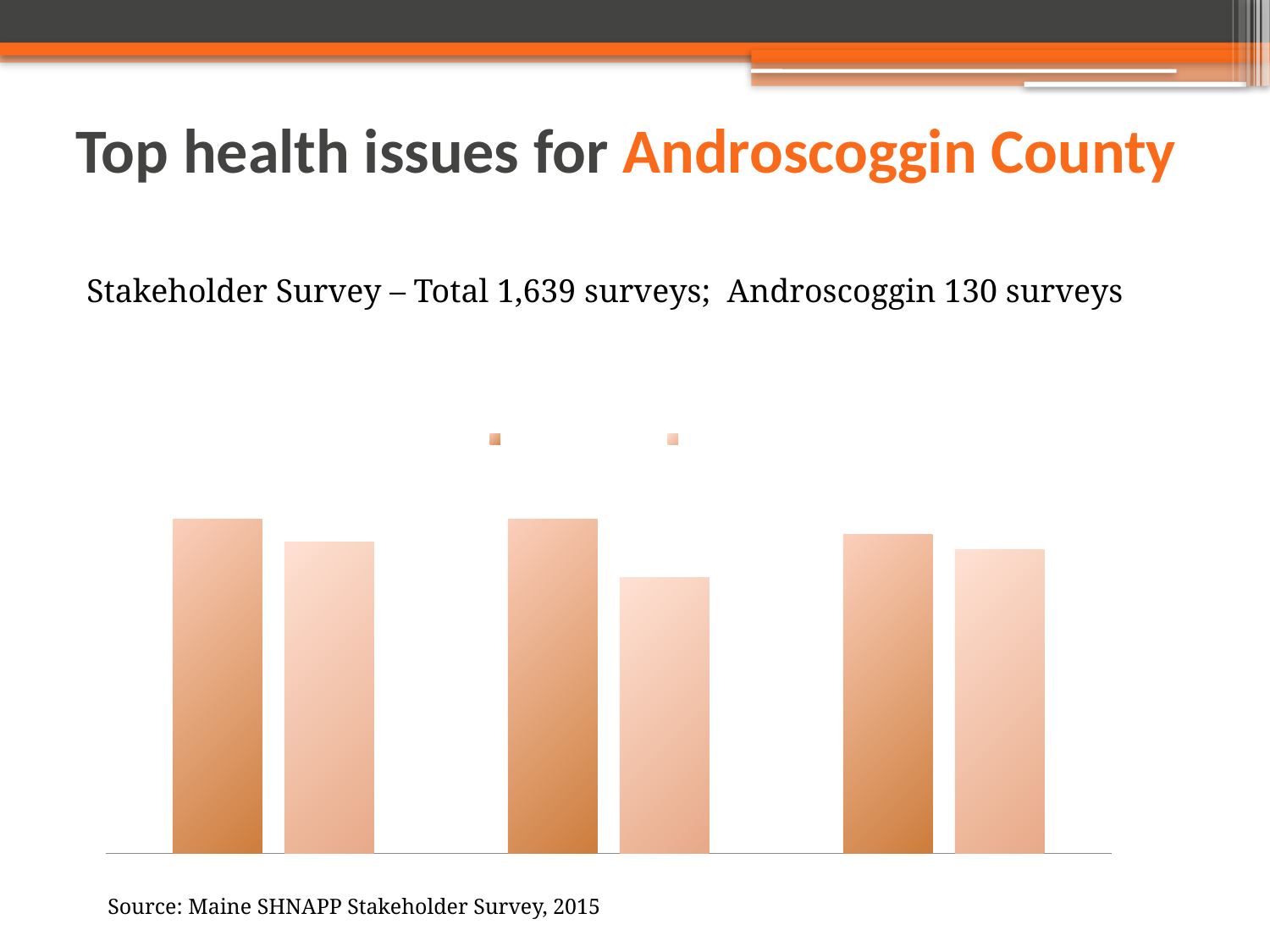
In the leftmost group of bars, which bar is taller, the darker orange bar or the lighter peach bar? the darker orange bar What kind of chart is shown on the slide? bar chart Which group of bars has the shortest lighter peach bar: the leftmost, middle, or rightmost group? the middle group In the rightmost group of bars, which bar is taller, the darker orange bar or the lighter peach bar? the darker orange bar How many series does the chart's legend list? 2 How many bars are plotted in total in the chart? 6 Are the bars in the chart vertical or horizontal? vertical What two colours are used for the bars in the chart? darker orange and lighter peach Which group of bars has the shortest darker orange bar: the leftmost, middle, or rightmost group? the rightmost group How many groups of bars (categories) are plotted in the chart? 3 In the middle group of bars, which bar is taller, the darker orange bar or the lighter peach bar? the darker orange bar